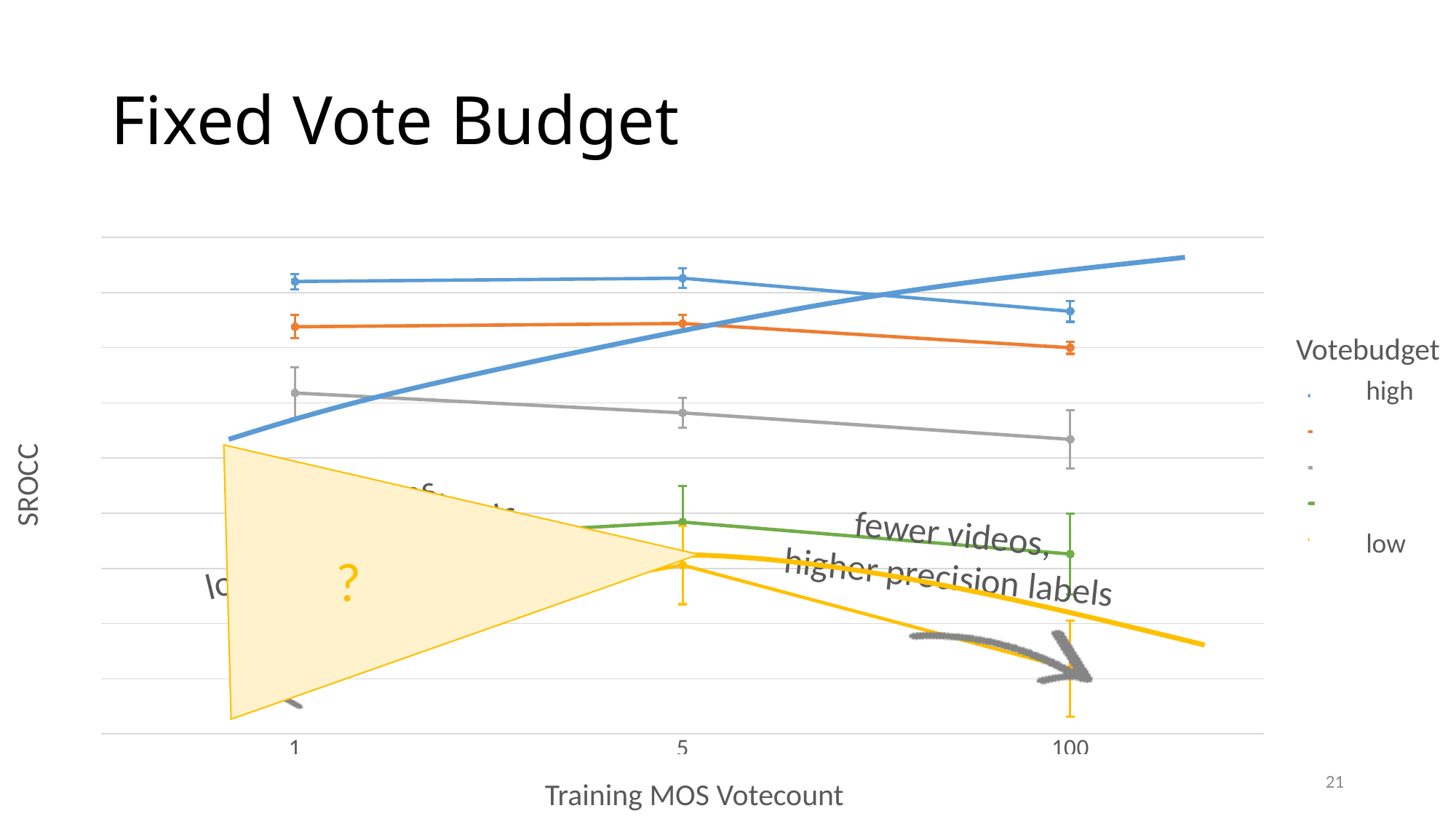
Does the gray series rise or fall as Training MOS Votecount increases from 1 to 100? fall How many Training MOS Votecount values are marked on the x axis? 3 Which Votebudget series has the highest SROCC at a Training MOS Votecount of 5? high What is the title of the chart's legend? Votebudget How many series does the Votebudget legend list? 5 Which Votebudget series has the lowest SROCC at a Training MOS Votecount of 100? low At a Training MOS Votecount of 1, which series has the larger SROCC, the high series or the gray series? high What kind of chart is shown on the slide? line chart At a Training MOS Votecount of 100, which series has the larger SROCC, high or low? high Does the high series rise or fall between a Training MOS Votecount of 5 and 100? fall What is the title of the x axis? Training MOS Votecount